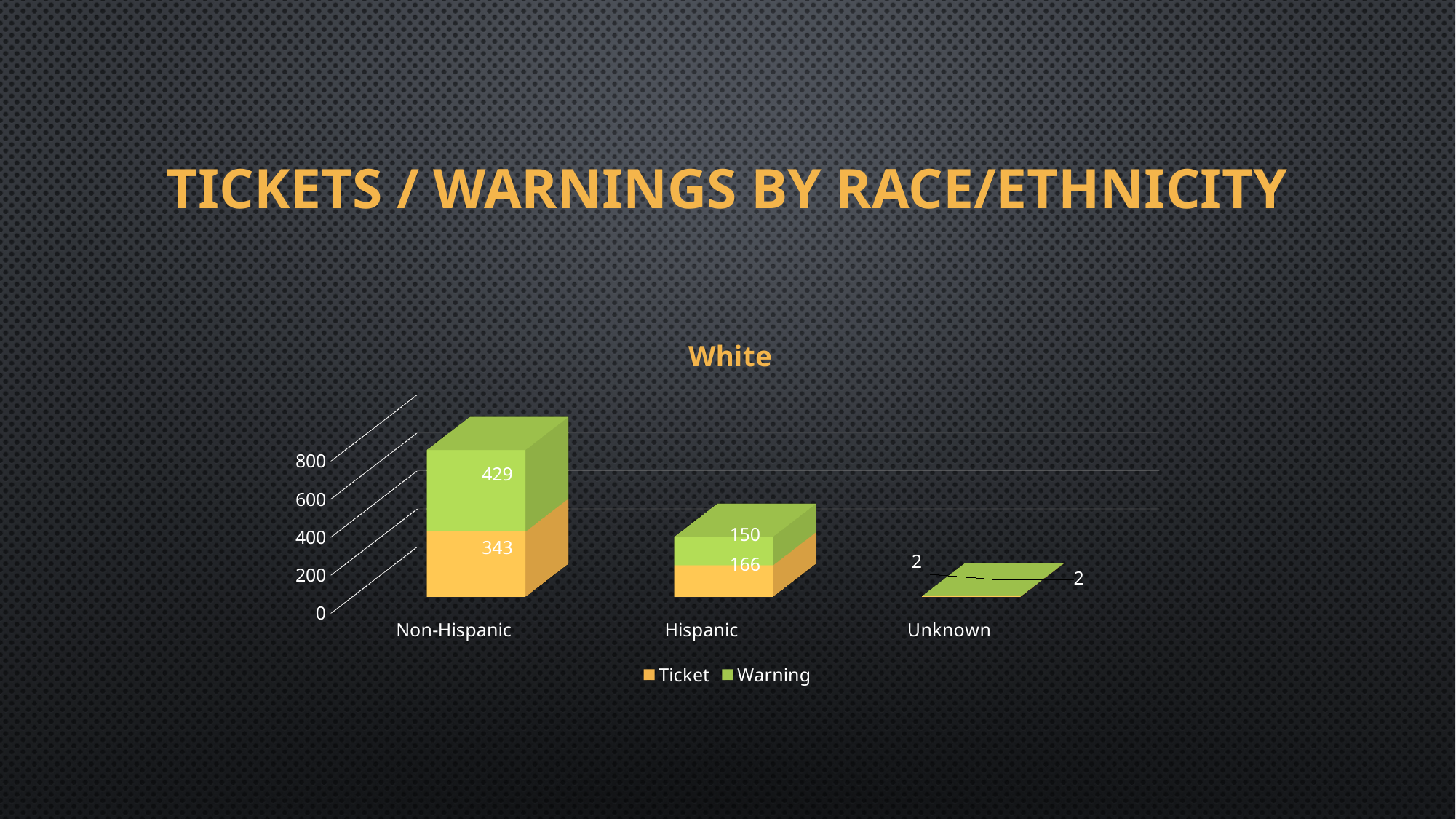
Which category has the lowest Ticket value? Unknown What is the Ticket value for Non-Hispanic? 343 How many series does the legend list? 2 What is the Ticket value for Unknown? 2 What is the Warning value for Non-Hispanic? 429 What is the Warning value for Hispanic? 150 What is the Ticket value for Hispanic? 166 What is the title of the chart? White What is the total of the stacked bar for Non-Hispanic? 772 Which is larger for Hispanic, the Ticket value or the Warning value? Ticket Which category has the highest Warning value? Non-Hispanic What is the difference between the Warning and Ticket values for Non-Hispanic? 86